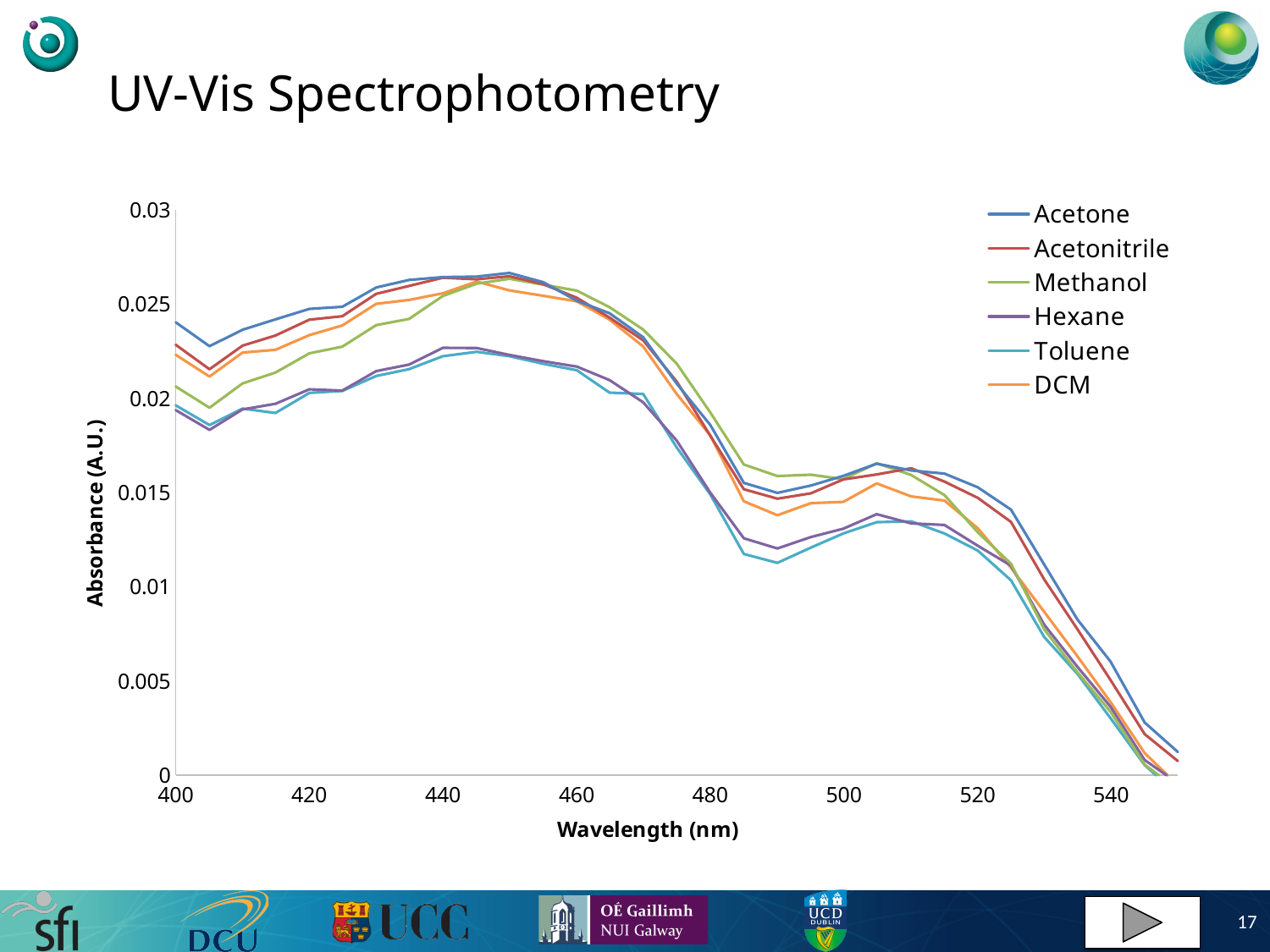
Do the values for Acetone rise or fall between 500 nm and 540 nm? fall Is the value for Hexane at 440 nm greater or less than 0.025? less What kind of chart is shown on the slide? line chart Is the value for Acetone at 440 nm greater or less than 0.025? greater Is the value for Toluene at 540 nm greater or less than 0.005? less How many series does the legend list? 6 At 400 nm, which series has the higher value, Acetone or Hexane? Acetone What is the title of the y axis? Absorbance (A.U.) At 490 nm, which series has the higher value, Methanol or Toluene? Methanol What is the title of the x axis? Wavelength (nm)